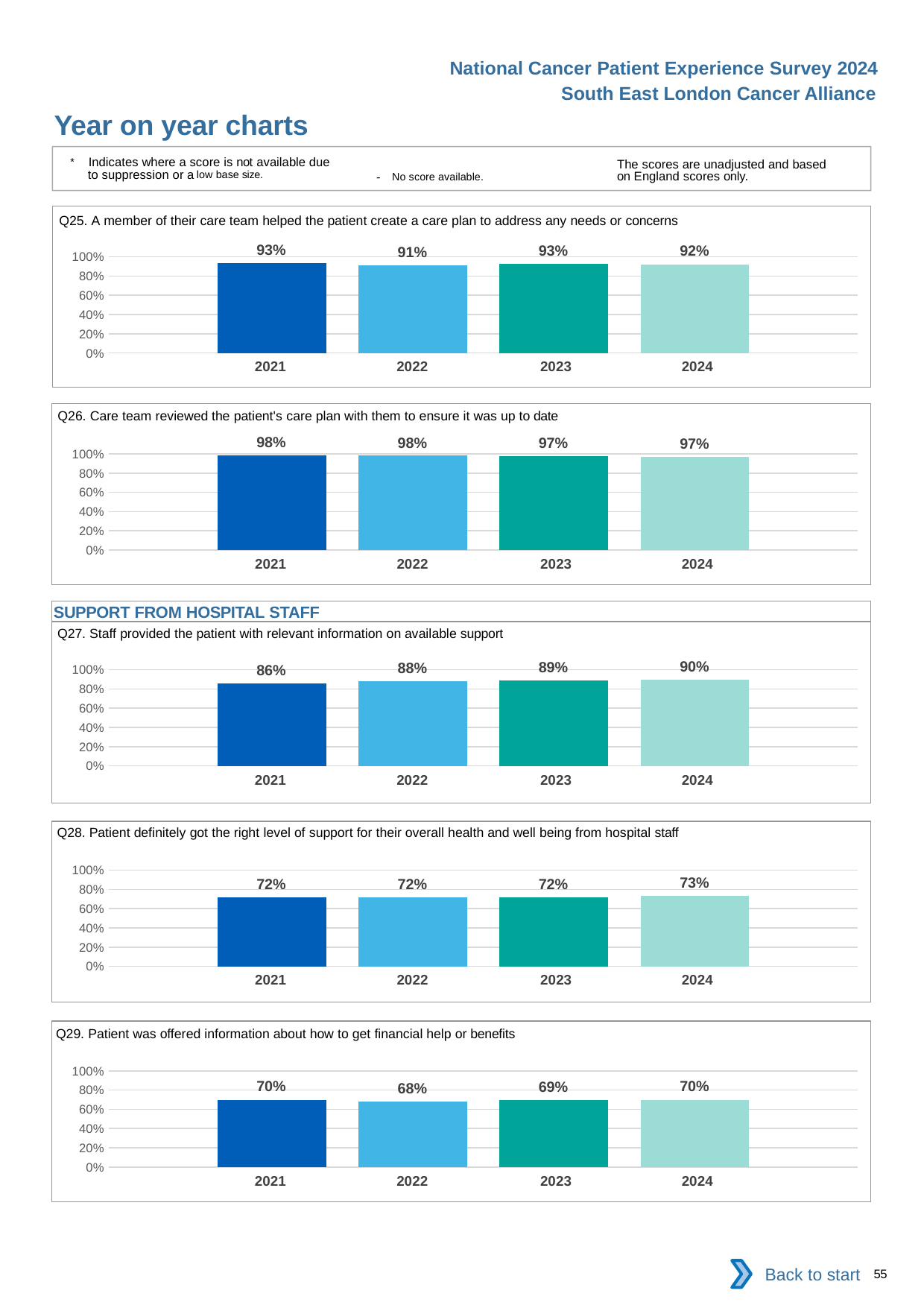
In the Q27 chart, what is the difference between the 2024 and 2021 values? 4% In the Q29 chart, what is the difference between the 2021 and 2022 values? 2% In the Q27 chart, which year has the lowest value? 2021 In the Q26 chart, what is the value for 2024? 97% In the Q28 chart, what is the value for 2024? 73% In the Q27 chart, do the values rise or fall from 2021 to 2024? rise In the Q25 chart, is the value for 2023 greater or less than 80%? greater In the Q29 chart, which year has the lowest value? 2022 In the Q25 chart, what is the value for 2022? 91% What kind of chart is the Q25 chart? bar chart How many years are shown in the Q28 chart? 4 In the Q27 chart, which year has the highest value? 2024